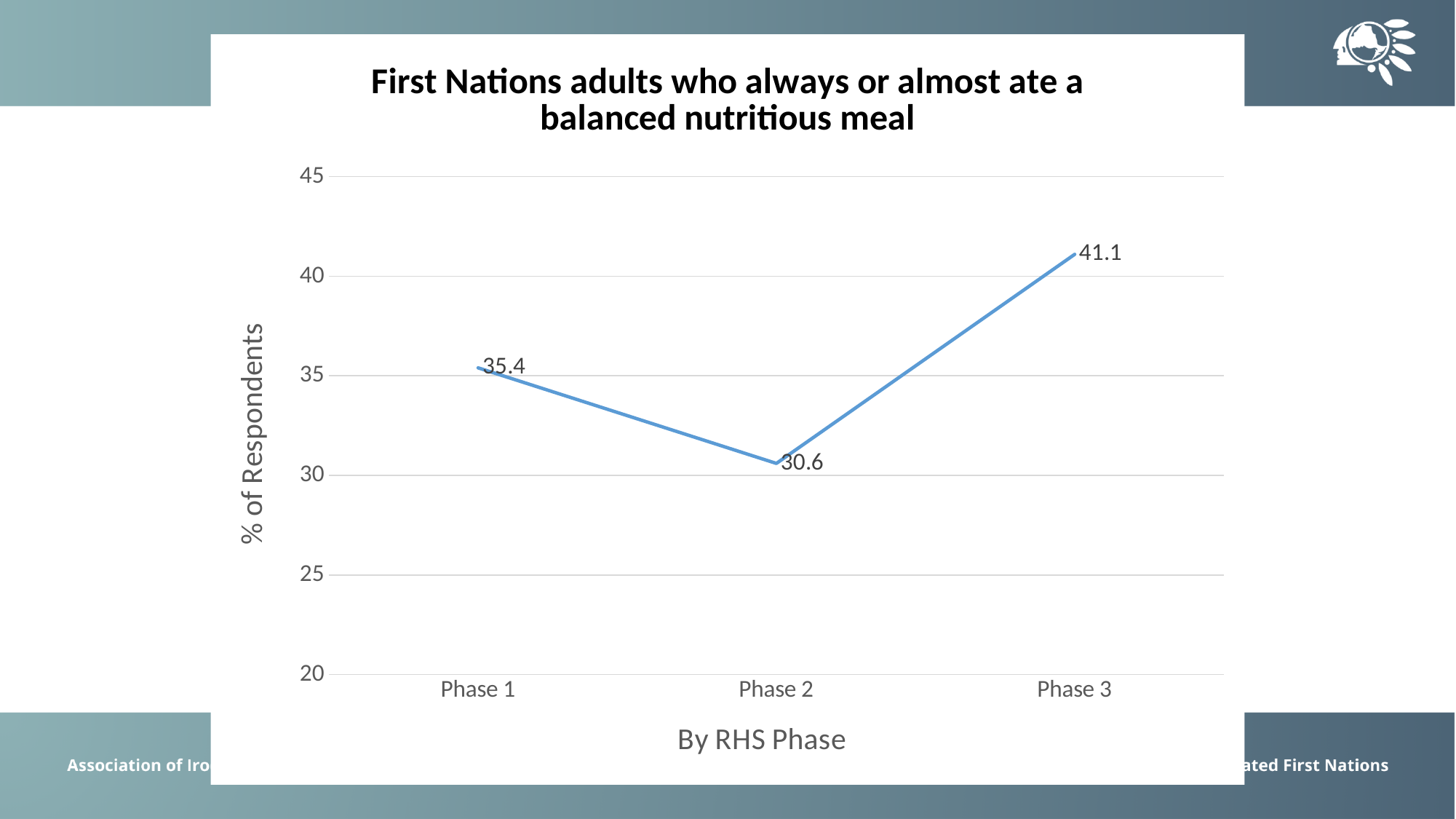
How many phases are plotted on the chart? 3 What kind of chart is shown on the slide? line chart What is the value for Phase 1? 35.4 Which is larger, the value for Phase 1 or the value for Phase 3? Phase 3 What is the value for Phase 3? 41.1 What is the difference between the values for Phase 3 and Phase 2? 10.5 Which phase has the lowest value? Phase 2 Is the value for Phase 3 greater or less than 40? greater What is the difference between the values for Phase 1 and Phase 2? 4.8 What is the label of the y axis? % of Respondents Which phase has the highest value? Phase 3 What is the value for Phase 2? 30.6